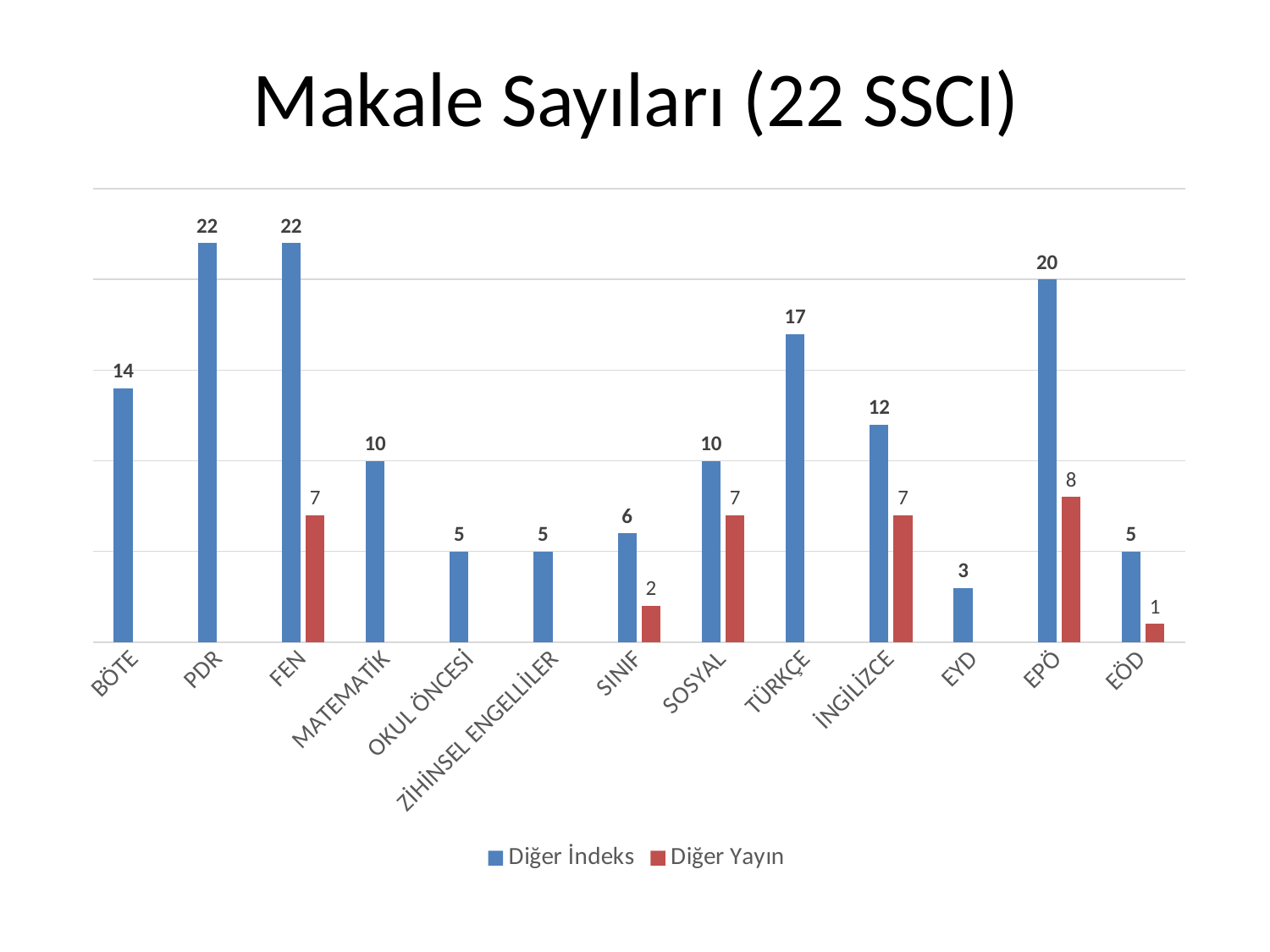
How many categories are shown on the x axis? 13 How many series does the legend list? 2 Which category has the lowest Diğer İndeks value? EYD What is the Diğer İndeks value for BÖTE? 14 What kind of chart is shown on the slide? Bar chart Which is larger, the Diğer İndeks value for İNGİLİZCE or for SOSYAL? İNGİLİZCE What is the Diğer Yayın value for EPÖ? 8 What is the Diğer İndeks value for TÜRKÇE? 17 What is the title of the chart? Makale Sayıları (22 SSCI) Which category has the highest Diğer Yayın value? EPÖ What is the difference between the Diğer İndeks values for PDR and MATEMATİK? 12 What is the Diğer Yayın value for SINIF? 2